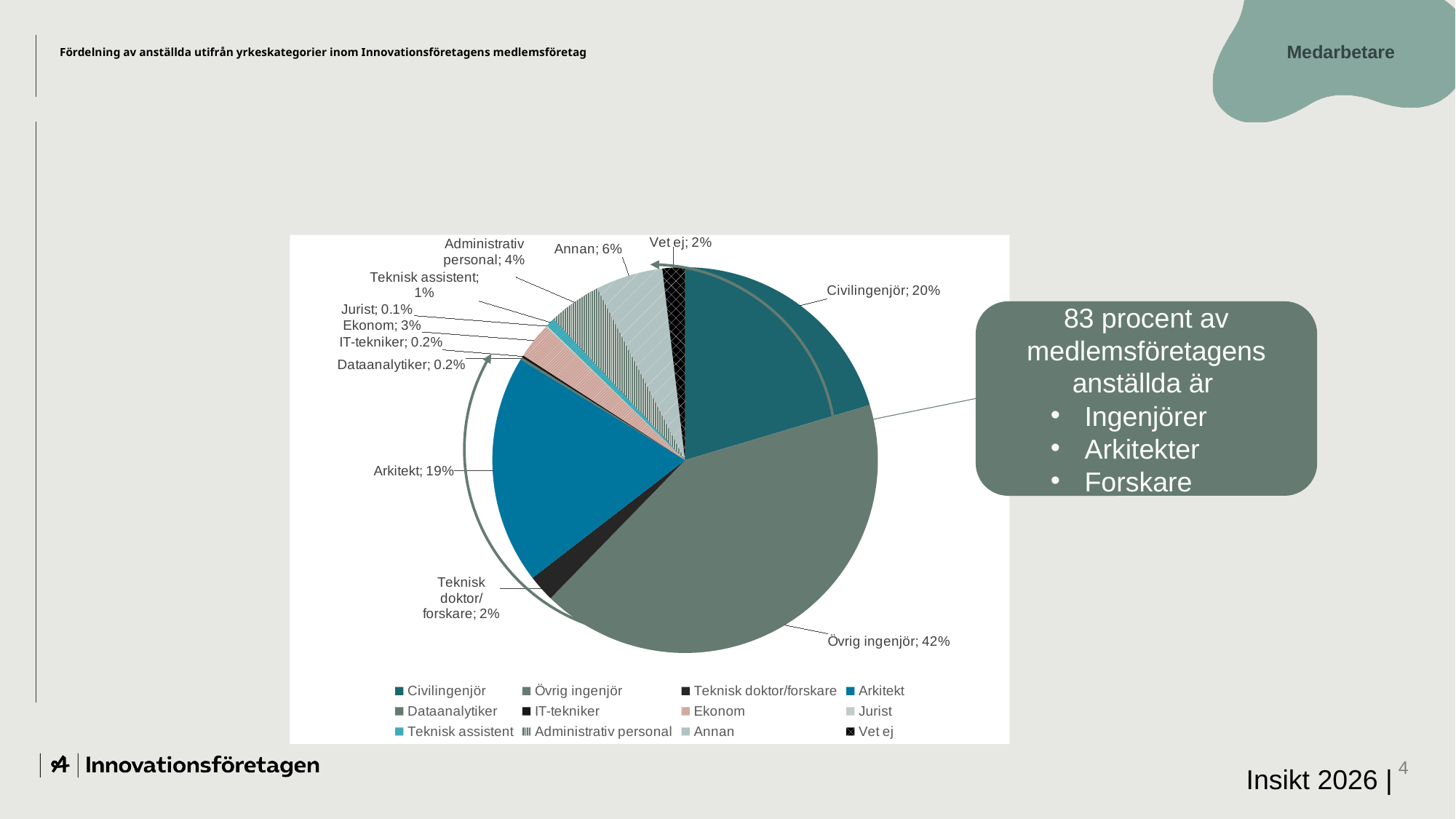
How many categories does the legend list? 12 What share of employees are Arkitekt? 19% What share of employees are Civilingenjör? 20% Which is larger, the share for Annan or the share for Administrativ personal? Annan What is the difference in percentage points between Övrig ingenjör and Civilingenjör? 22 What share of employees are Ekonom? 3% What type of chart is shown on the slide? pie chart What is the title of the chart? Fördelning av anställda utifrån yrkeskategorier inom Innovationsföretagens medlemsföretag What share of employees are Övrig ingenjör? 42% What share of employees are Jurist? 0.1% Which category has the largest share of the pie? Övrig ingenjör Which category has the smallest share of the pie? Jurist